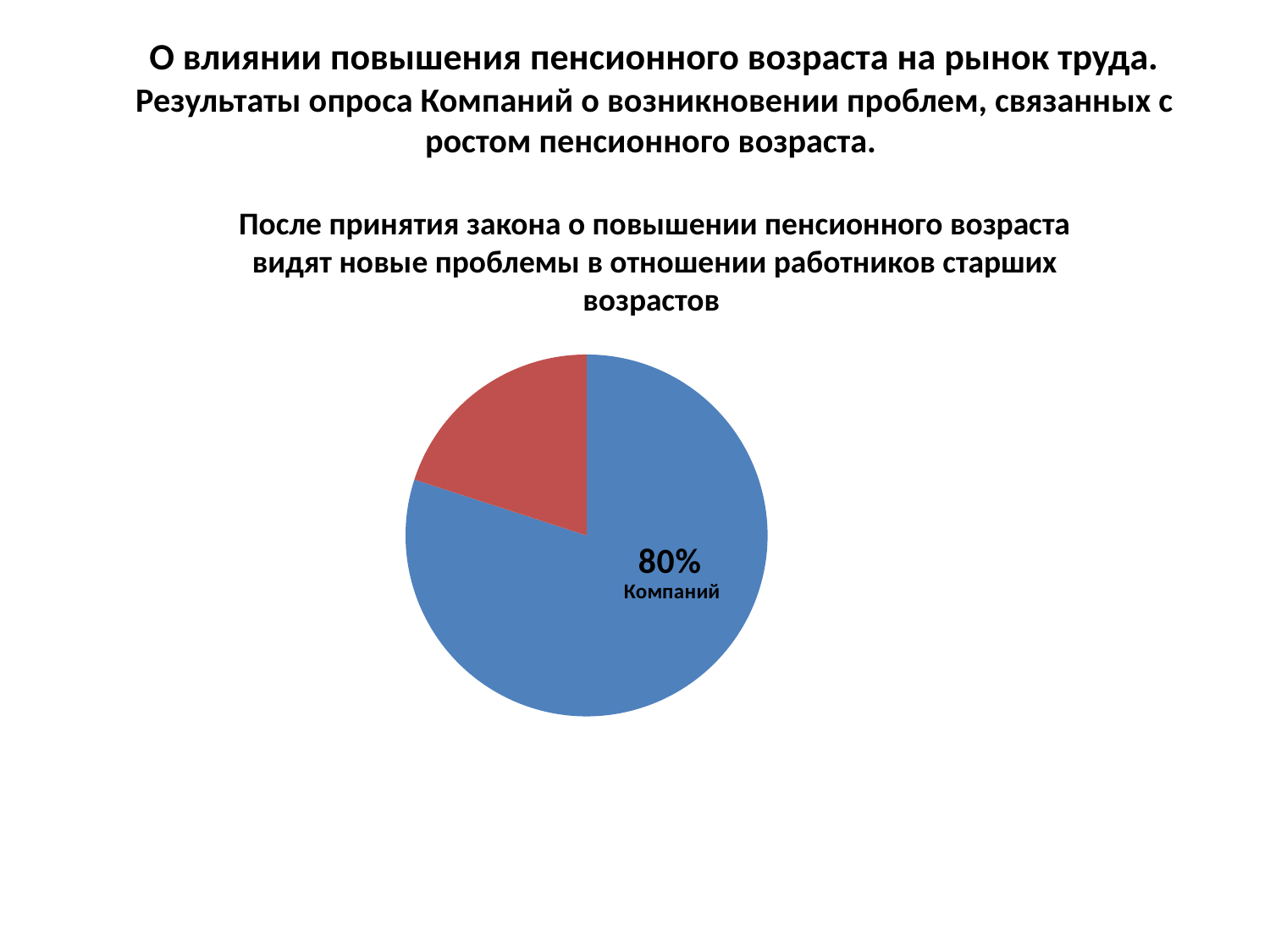
What kind of chart is shown on the slide? pie chart What colour is the slice of the pie chart labelled 80%? blue What share of companies is shown by the labelled slice of the pie chart? 80% Is the blue slice of the pie chart larger or smaller than the red slice? larger What is the title of the pie chart? После принятия закона о повышении пенсионного возраста видят новые проблемы в отношении работников старших возрастов Which slice of the pie chart is the smallest, the blue one or the red one? the red one How many slices does the pie chart have? 2 Which slice of the pie chart is the largest, the blue one or the red one? the blue one What is the data label printed on the blue slice of the pie chart? 80% Компаний